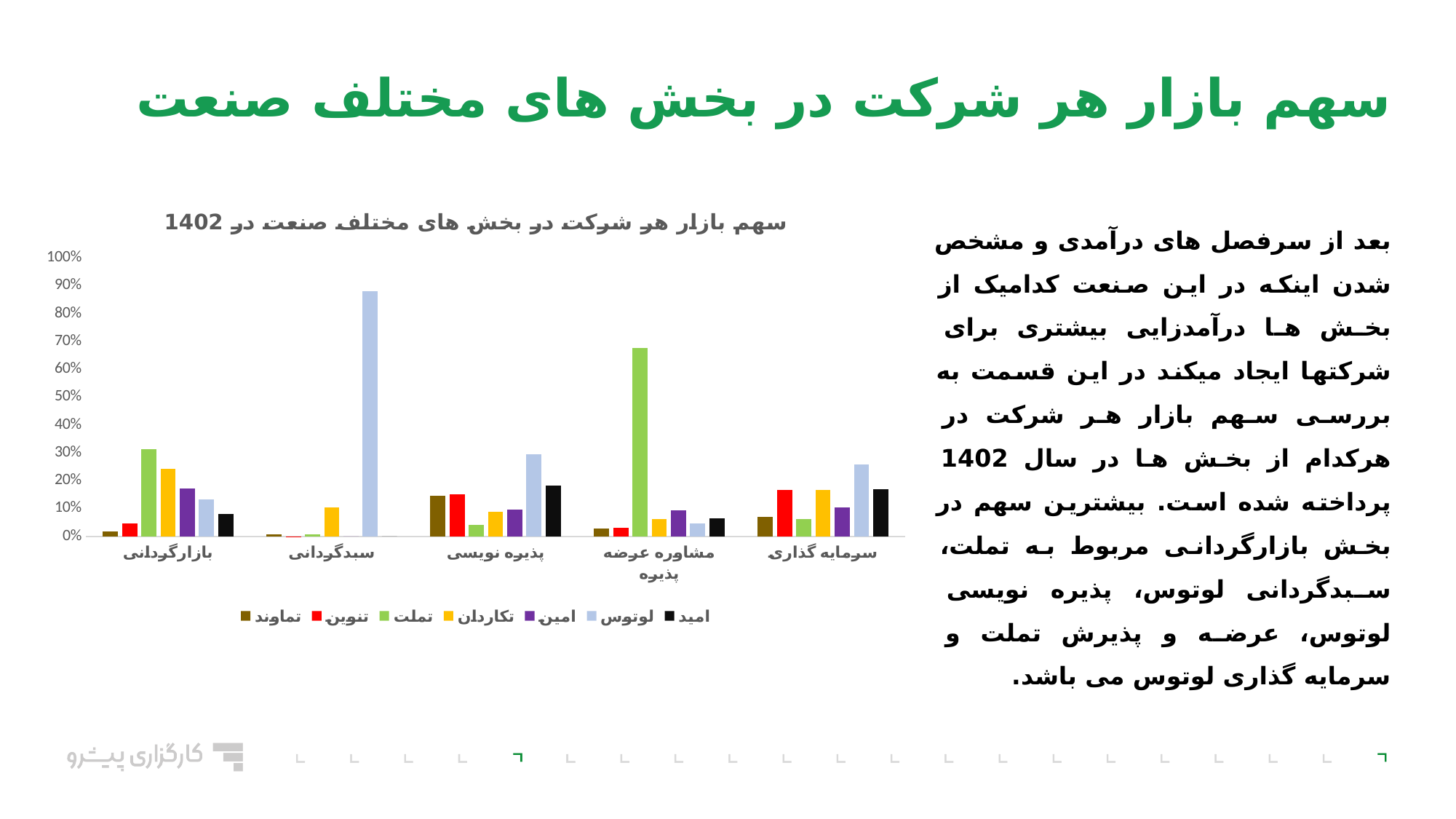
What kind of chart is shown on the slide? bar chart How many categories are shown on the x axis of the chart? 5 In the بازارگردانی category, which is larger: the value for تملت or the value for تکاردان? تملت Is the value for لوتوس in سبدگردانی greater or less than 80%? greater What is the title of the chart? سهم بازار هر شرکت در بخش های مختلف صنعت در 1402 Is the value for لوتوس in پذیره نویسی greater or less than 20%? greater Which company has the highest bar in the بازارگردانی category? تملت Is the value for تملت in مشاوره عرضه پذیره greater or less than 60%? greater Which company has the highest bar in the سبدگردانی category? لوتوس How many series does the chart legend list? 7 Which company has the highest bar in the سرمایه گذاری category? لوتوس